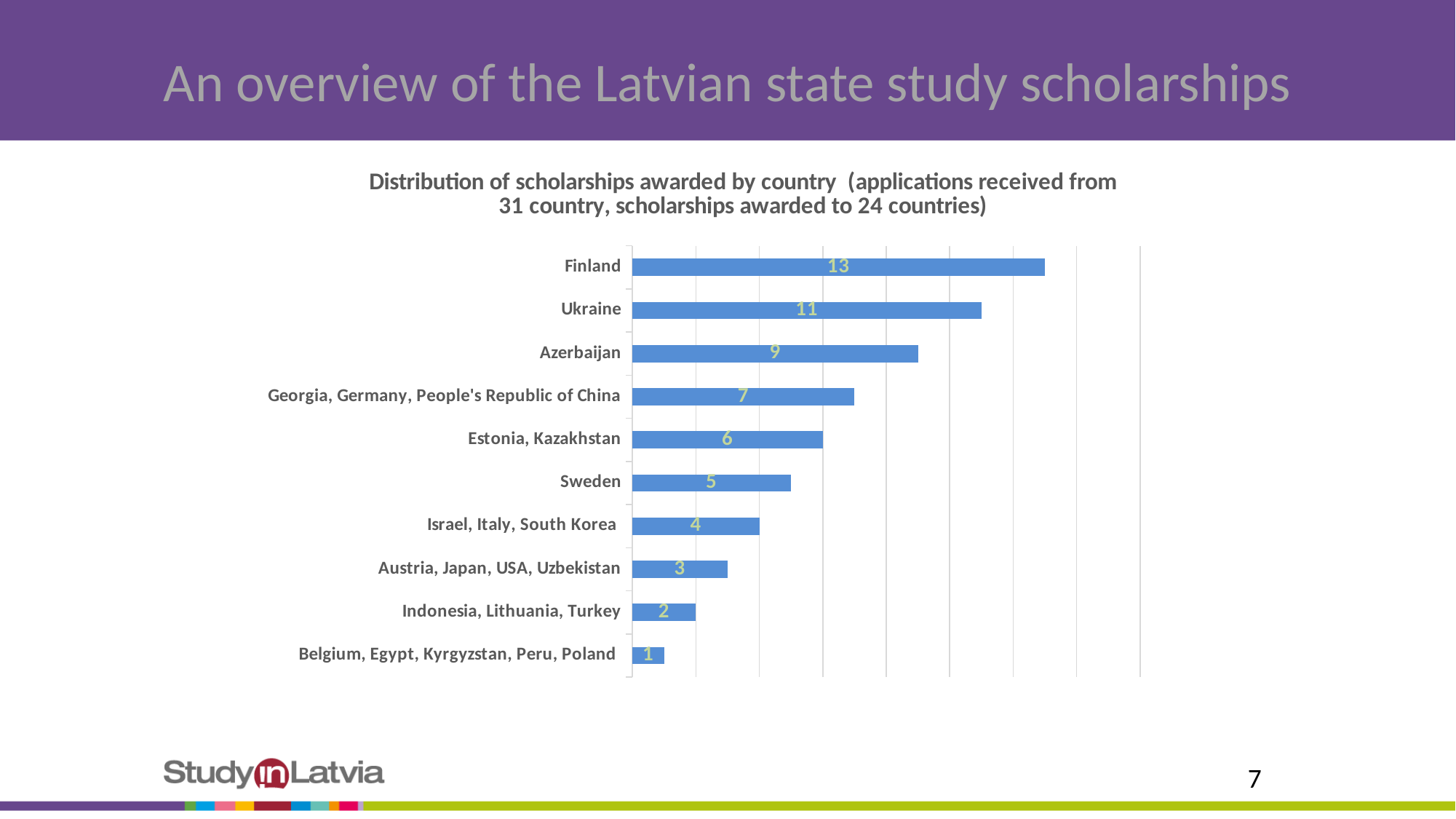
Which category has the lowest value in the chart? Belgium, Egypt, Kyrgyzstan, Peru, Poland Which category has the highest value in the chart? Finland What is the title of the chart? Distribution of scholarships awarded by country (applications received from 31 country, scholarships awarded to 24 countries) What kind of chart is shown on the slide? Bar chart What is the difference between the values for Finland and Azerbaijan? 4 How many scholarships were awarded to Finland? 13 What is the value shown for 'Georgia, Germany, People's Republic of China'? 7 How many categories are shown in the chart? 10 What value is shown for the category 'Estonia, Kazakhstan'? 6 What is the difference between the values for Ukraine and Sweden? 6 What is the value shown for Ukraine? 11 Which has a larger value, Sweden or 'Israel, Italy, South Korea'? Sweden